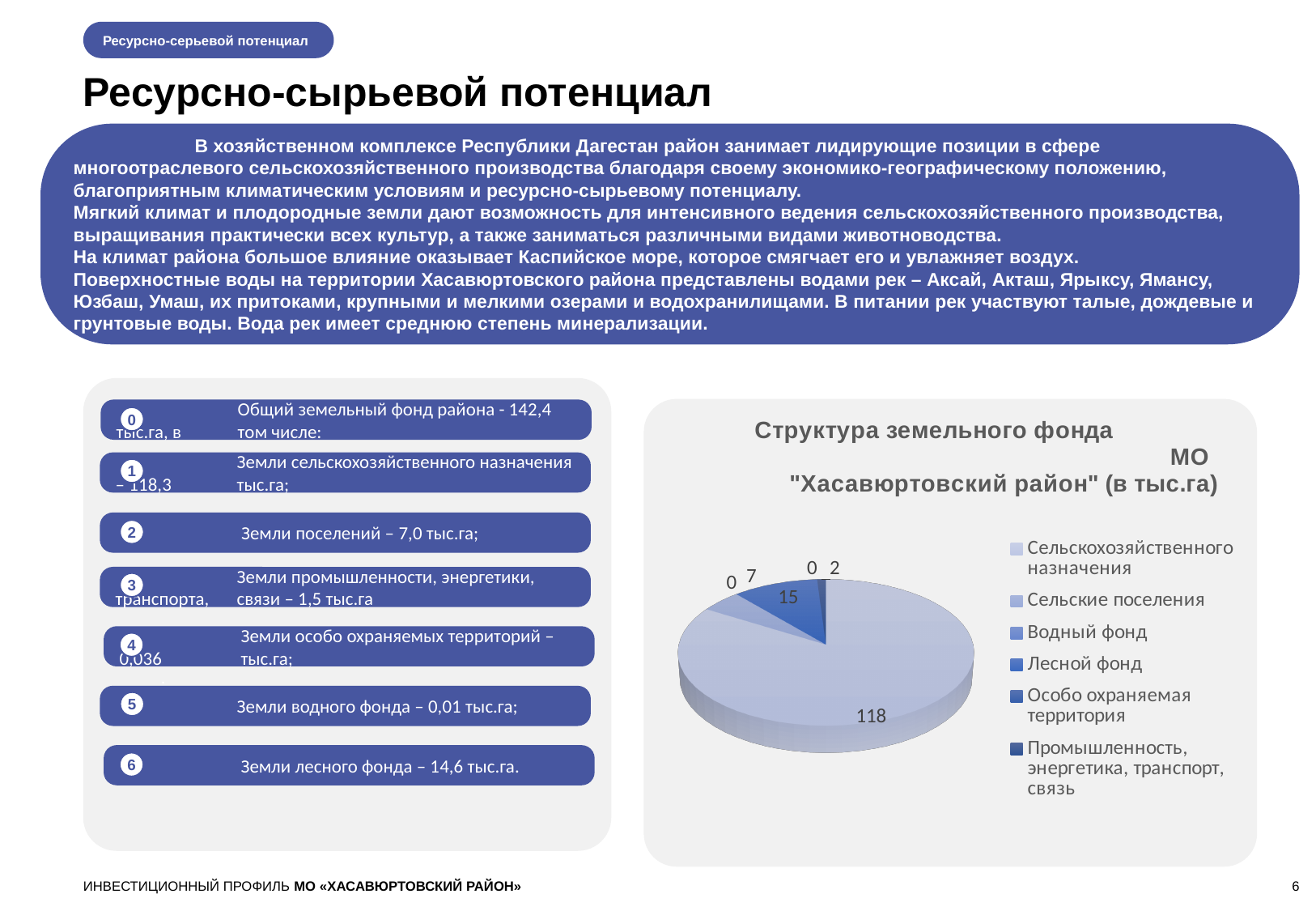
Which is larger in the pie chart, Лесной фонд or Сельские поселения? Лесной фонд What unit is stated in the title of the pie chart? тыс.га What value is shown for Водный фонд in the pie chart? 0 What is the total of all the values labelled on the pie chart? 142 What kind of chart is shown on the slide? pie chart What value is shown for Сельскохозяйственного назначения in the pie chart? 118 What value is shown for Сельские поселения in the pie chart? 7 Which category has the largest slice in the pie chart? Сельскохозяйственного назначения What value is shown for Промышленность, энергетика, транспорт, связь in the pie chart? 2 How many entries does the legend of the pie chart list? 6 What value is shown for Лесной фонд in the pie chart? 15 What is the difference between the values for Сельскохозяйственного назначения and Лесной фонд in the pie chart? 103